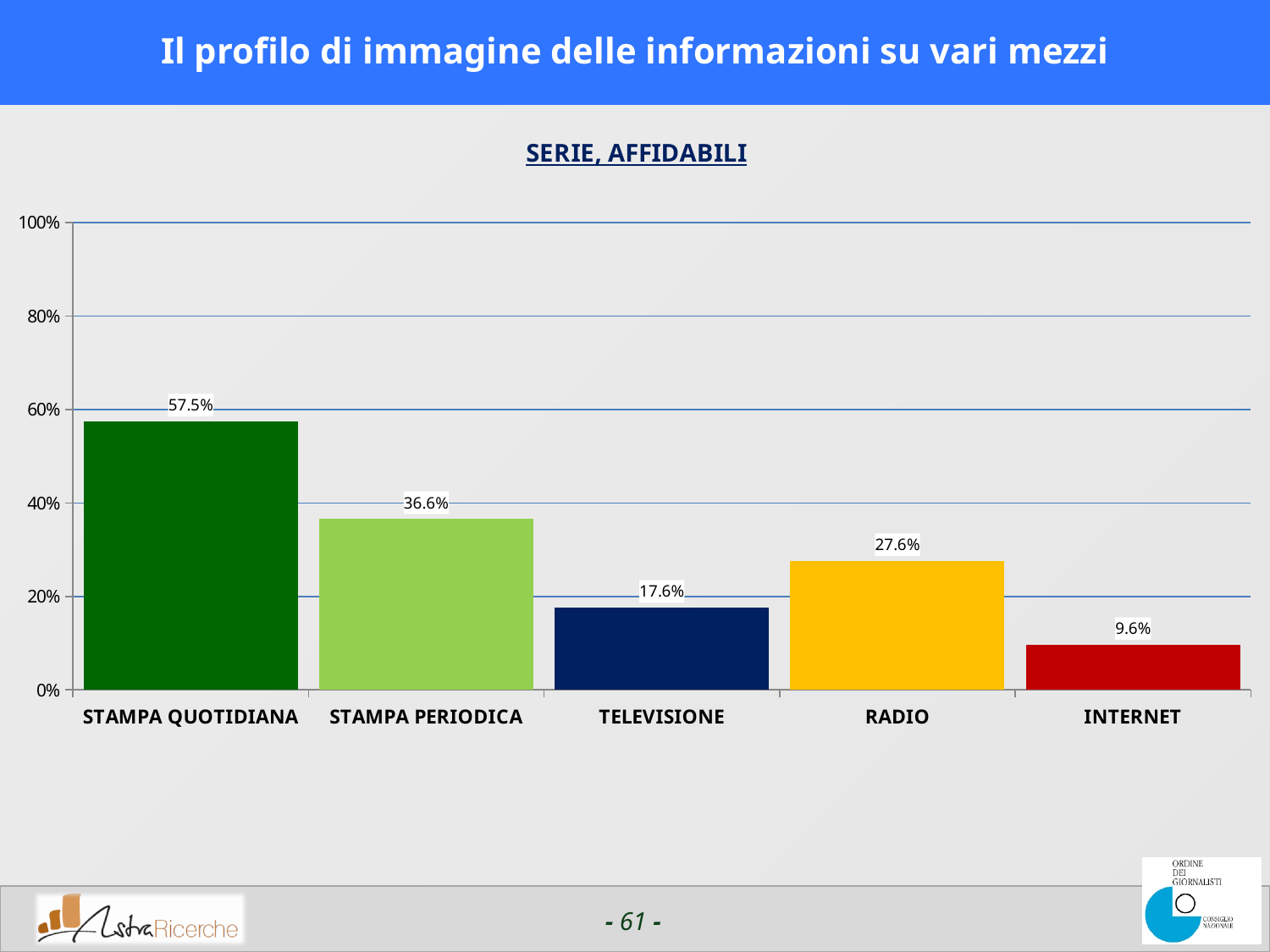
What is the title shown above the chart? SERIE, AFFIDABILI Which category has the lowest value? INTERNET What is the difference between the values for STAMPA QUOTIDIANA and STAMPA PERIODICA? 20.9% Which category has the highest value? STAMPA QUOTIDIANA Is the value for STAMPA PERIODICA greater or less than 40%? less How many categories are shown on the x axis? 5 What is the value for STAMPA QUOTIDIANA? 57.5% What kind of chart is shown on the slide? bar chart What is the value for INTERNET? 9.6% What is the value for RADIO? 27.6% Which is larger, the value for TELEVISIONE or the value for RADIO? RADIO What is the difference between the values for RADIO and TELEVISIONE? 10.0%